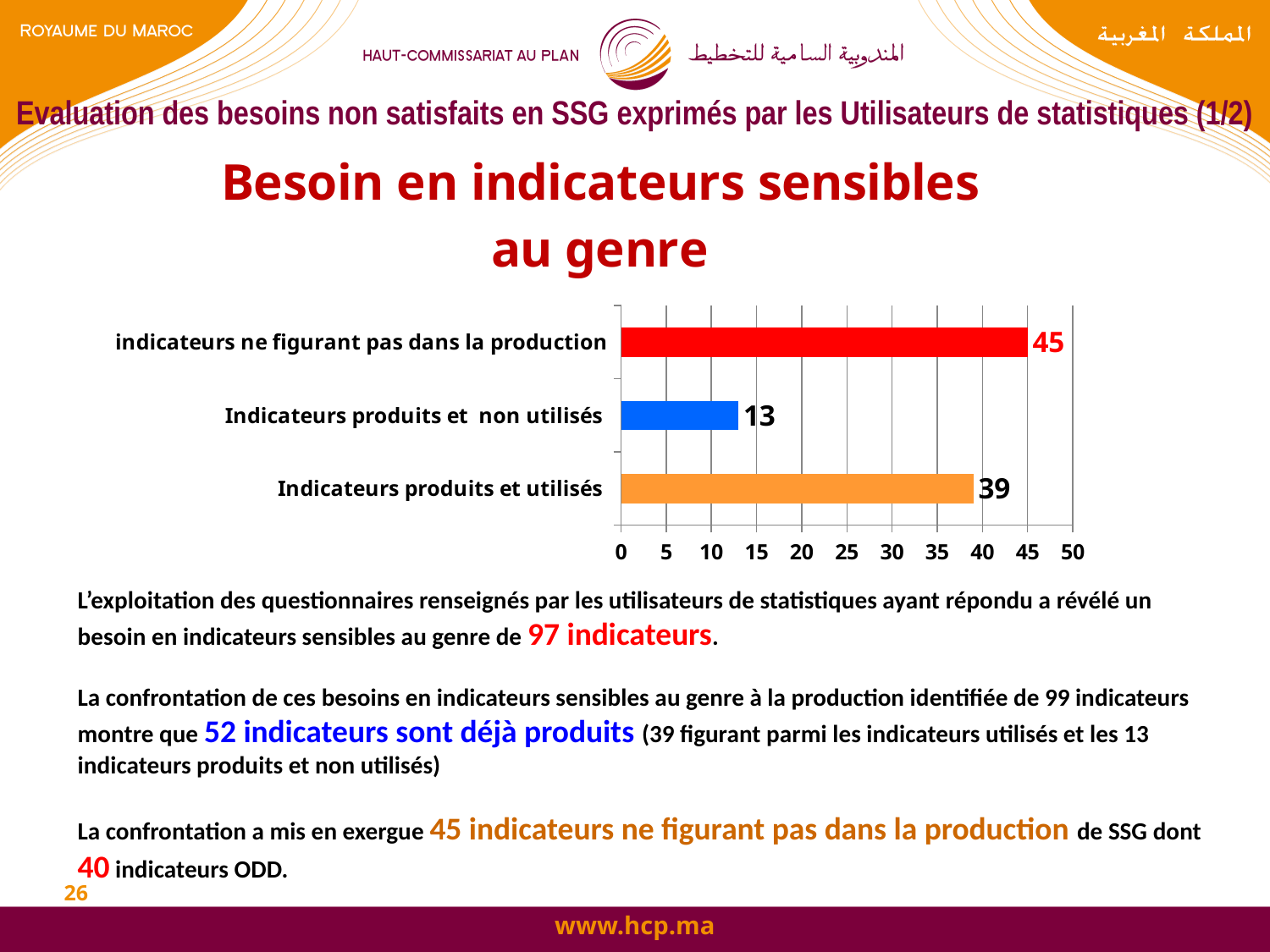
What is the value for "indicateurs ne figurant pas dans la production"? 45 What is the title of the chart? Besoin en indicateurs sensibles au genre Is the value for "Indicateurs produits et non utilisés" greater or less than 20? less What is the value for "Indicateurs produits et non utilisés"? 13 What is the difference between the values for "Indicateurs produits et utilisés" and "Indicateurs produits et non utilisés"? 26 Which category has the lowest value? Indicateurs produits et non utilisés What is the difference between the values for "indicateurs ne figurant pas dans la production" and "Indicateurs produits et utilisés"? 6 What kind of chart is shown on the slide? bar chart Which category has the highest value? indicateurs ne figurant pas dans la production How many categories are shown in the chart? 3 What is the value for "Indicateurs produits et utilisés"? 39 Which is larger: the value for "Indicateurs produits et utilisés" or for "Indicateurs produits et non utilisés"? Indicateurs produits et utilisés